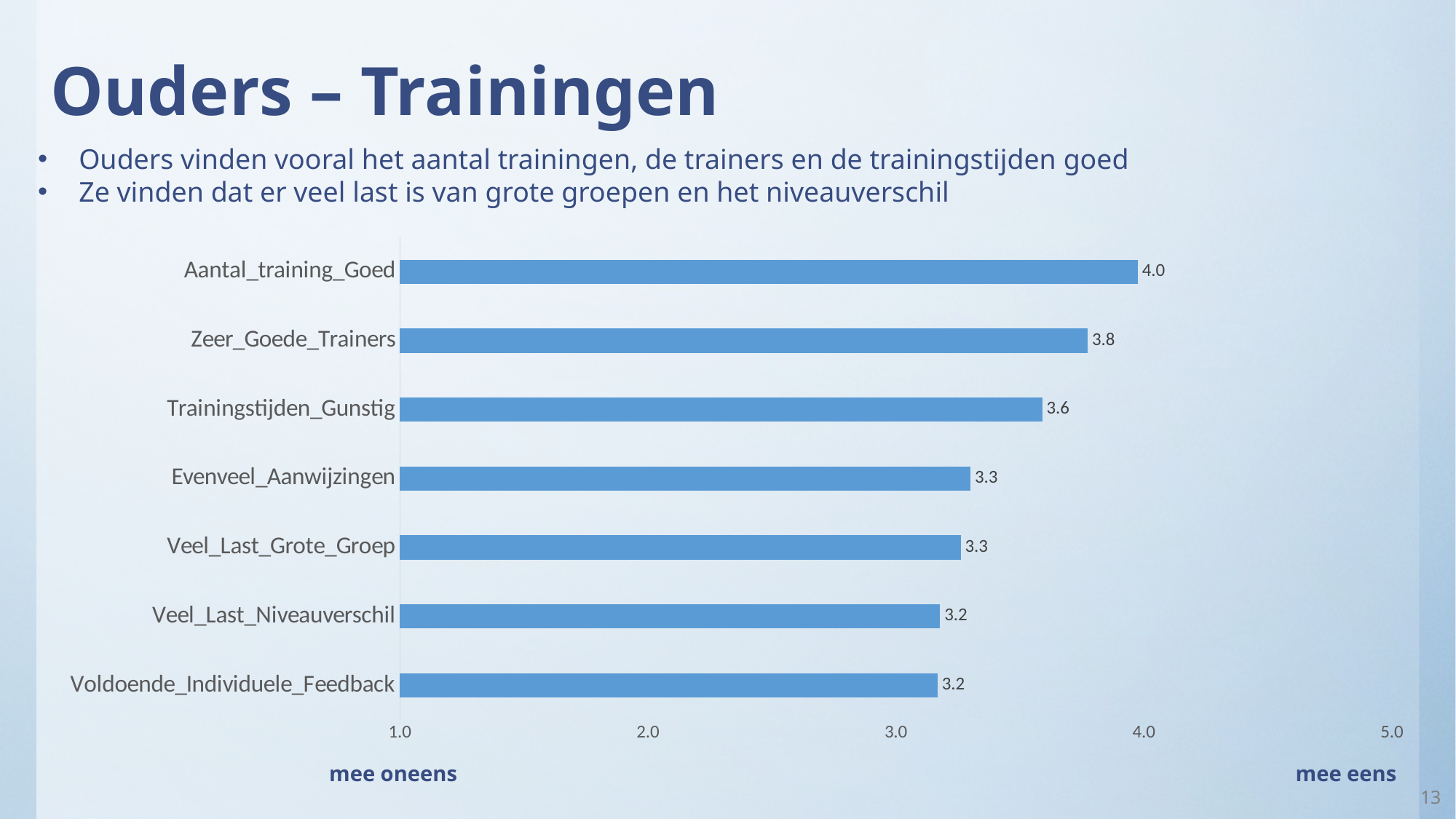
What kind of chart is shown on the slide? bar chart What is the value for Aantal_training_Goed? 4.0 What is the difference between the values for Aantal_training_Goed and Zeer_Goede_Trainers? 0.2 Which is larger, the value for Zeer_Goede_Trainers or the value for Evenveel_Aanwijzingen? Zeer_Goede_Trainers Is the value for Veel_Last_Grote_Groep greater or less than 3.0? greater What is the value for Zeer_Goede_Trainers? 3.8 What is the value for Trainingstijden_Gunstig? 3.6 How many categories are shown in the chart? 7 What is the value for Veel_Last_Niveauverschil? 3.2 What labels appear at the left and right ends of the x axis? mee oneens and mee eens Which category has the highest value? Aantal_training_Goed What is the difference between the values for Trainingstijden_Gunstig and Voldoende_Individuele_Feedback? 0.4